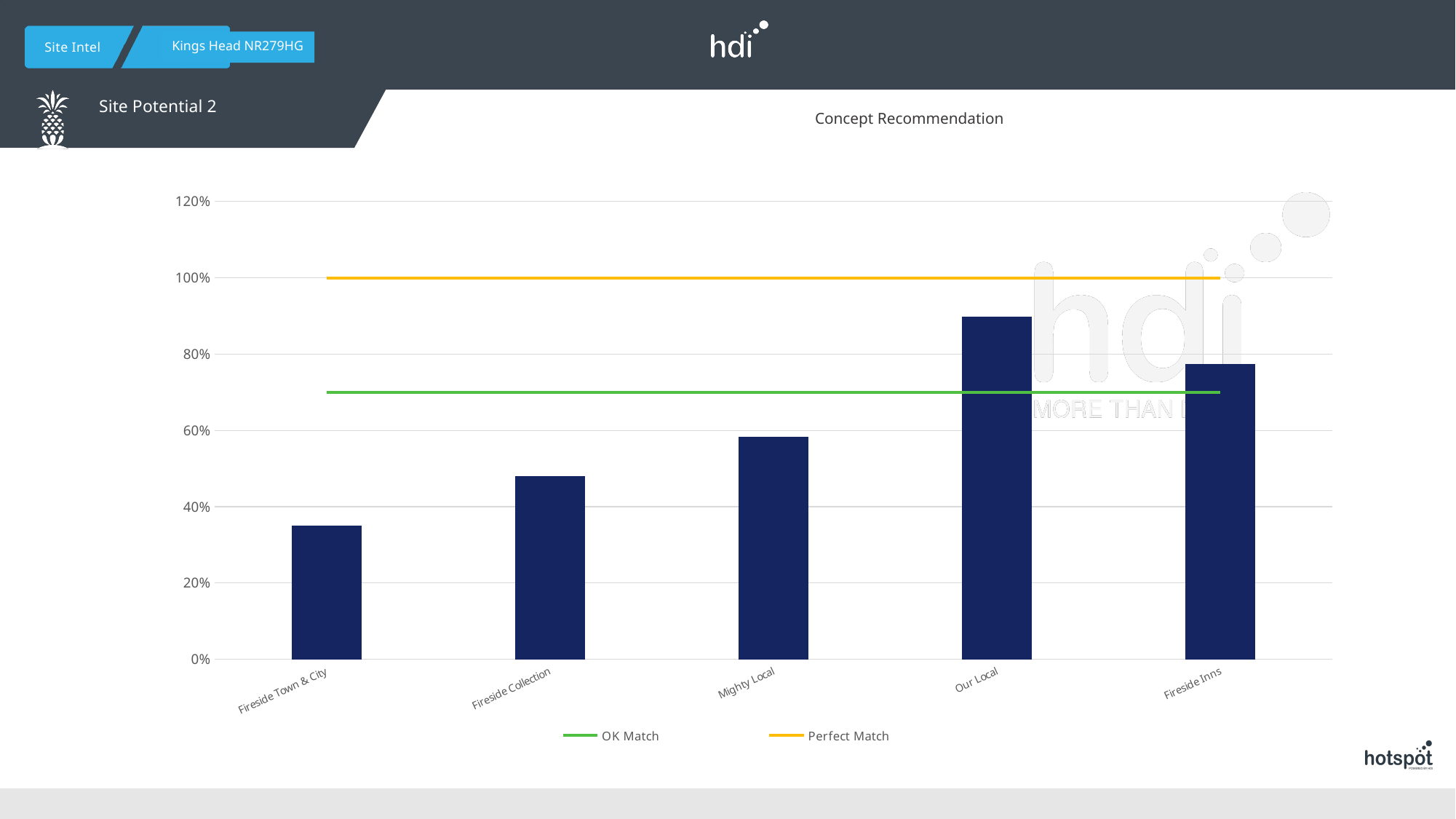
What is the title of the chart? Concept Recommendation Which concept has the highest bar? Our Local How many series does the legend list? 2 Which concept has the lowest bar? Fireside Town & City Is the value for Fireside Town & City greater or less than 40%? less Which is larger, the bar for Fireside Inns or the bar for Mighty Local? Fireside Inns Which is larger, the bar for Fireside Collection or the bar for Fireside Town & City? Fireside Collection Is the value for Our Local greater or less than 80%? greater What kind of chart is shown on the slide? combination bar and line chart Which legend entry is shown with a yellow line? Perfect Match How many concept categories are plotted along the x axis? 5 Is the value for Mighty Local greater or less than 60%? less